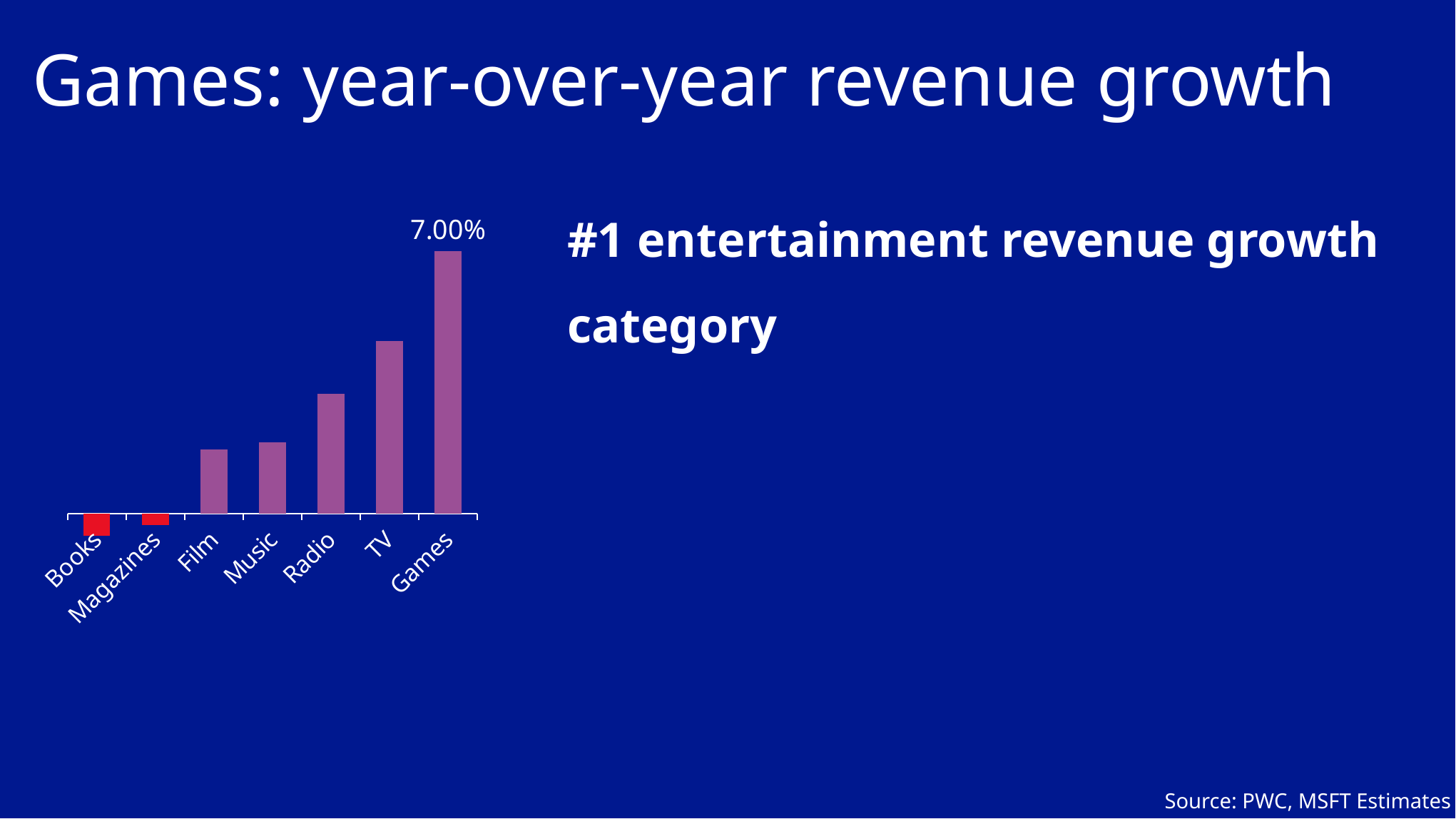
Which category has the lowest year-over-year revenue growth? Books What is the title of the slide containing the chart? Games: year-over-year revenue growth Which has the larger revenue growth, TV or Radio? TV How many categories are shown on the x axis of the chart? 7 Which has the larger revenue growth, Radio or Film? Radio Is the value for Books greater or less than 0? less Which category has the highest year-over-year revenue growth? Games What type of chart is shown on the slide? bar chart Do the bar values generally rise or fall moving from Books to Games along the x axis? rise What colour are the bars for Books and Magazines? red Which has the larger revenue growth, Games or TV? Games What is the year-over-year revenue growth value shown for Games? 7.00%